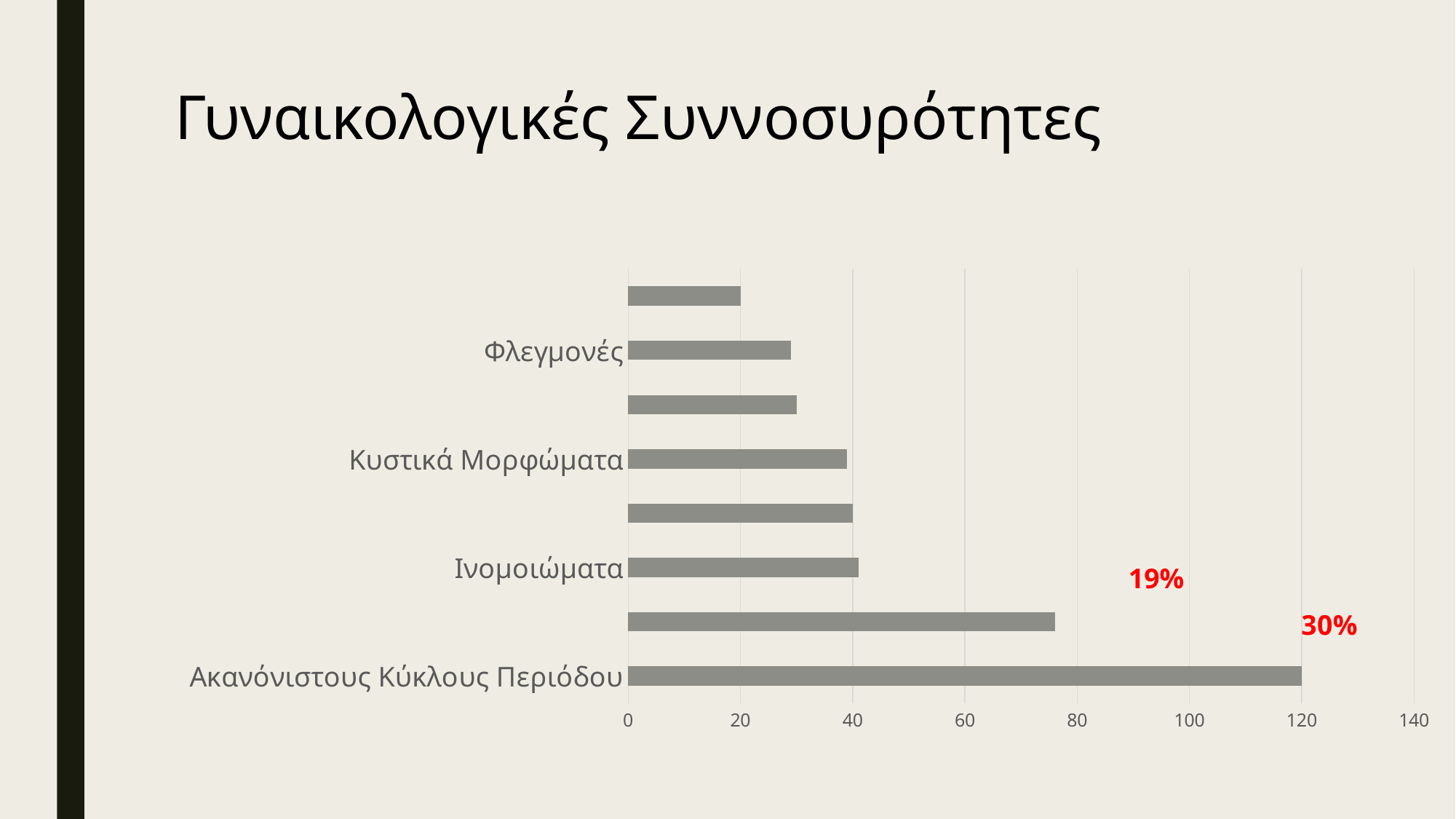
What is the title of the slide? Γυναικολογικές Συννοσυρότητες Is the value for Φλεγμονές greater or less than 20? greater Is the value for Ινομοιώματα greater or less than 60? less What is the value for Ακανόνιστους Κύκλους Περιόδου? 120 Which category has the highest value in the chart? Ακανόνιστους Κύκλους Περιόδου Which is larger, the value for Ινομοιώματα or the value for Φλεγμονές? Ινομοιώματα Is the value for Κυστικά Μορφώματα greater or less than 60? less What is the maximum value shown on the horizontal axis of the chart? 140 How many bars are plotted in the chart? 8 Which is larger, the value for Ακανόνιστους Κύκλους Περιόδου or the value for Κυστικά Μορφώματα? Ακανόνιστους Κύκλους Περιόδου What kind of chart is shown on the slide? bar chart